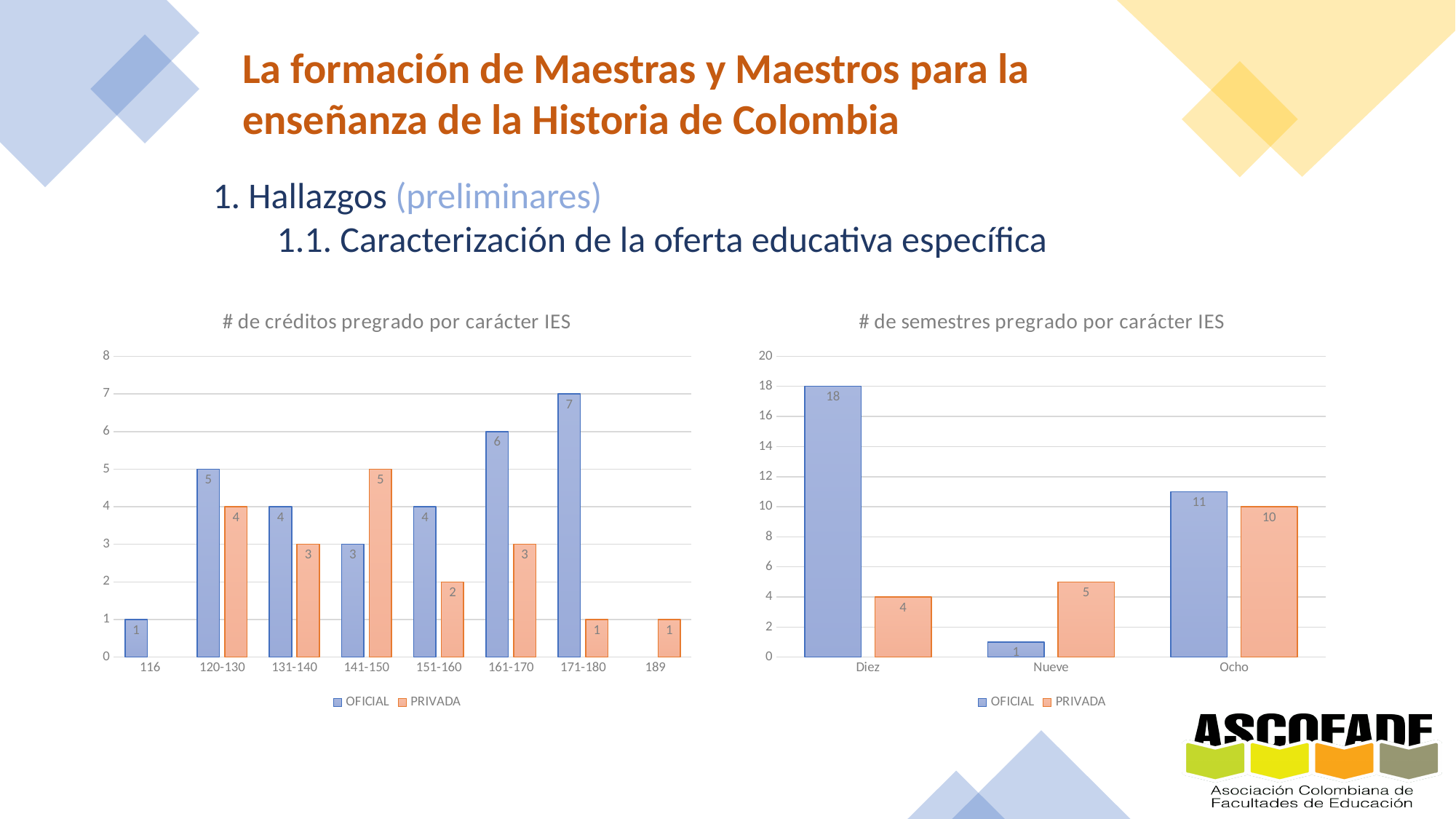
In the chart '# de créditos pregrado por carácter IES', how many categories are shown on the x axis? 8 What type of chart is '# de semestres pregrado por carácter IES'? Bar chart In the chart '# de semestres pregrado por carácter IES', which category has the lowest OFICIAL value? Nueve In the chart '# de créditos pregrado por carácter IES', which category has the highest OFICIAL value? 171-180 In the chart '# de semestres pregrado por carácter IES', what is the PRIVADA value for Ocho? 10 In the chart '# de créditos pregrado por carácter IES', what is the OFICIAL value for 171-180? 7 In the chart '# de semestres pregrado por carácter IES', what is the OFICIAL value for Diez? 18 How many series does the legend of the chart '# de semestres pregrado por carácter IES' list? 2 In the chart '# de créditos pregrado por carácter IES', what is the PRIVADA value for 141-150? 5 In the chart '# de semestres pregrado por carácter IES', what is the difference between the OFICIAL and PRIVADA values for Diez? 14 In the chart '# de créditos pregrado por carácter IES', which is larger for 120-130, OFICIAL or PRIVADA? OFICIAL In the chart '# de créditos pregrado por carácter IES', what is the difference between the OFICIAL and PRIVADA values for 161-170? 3